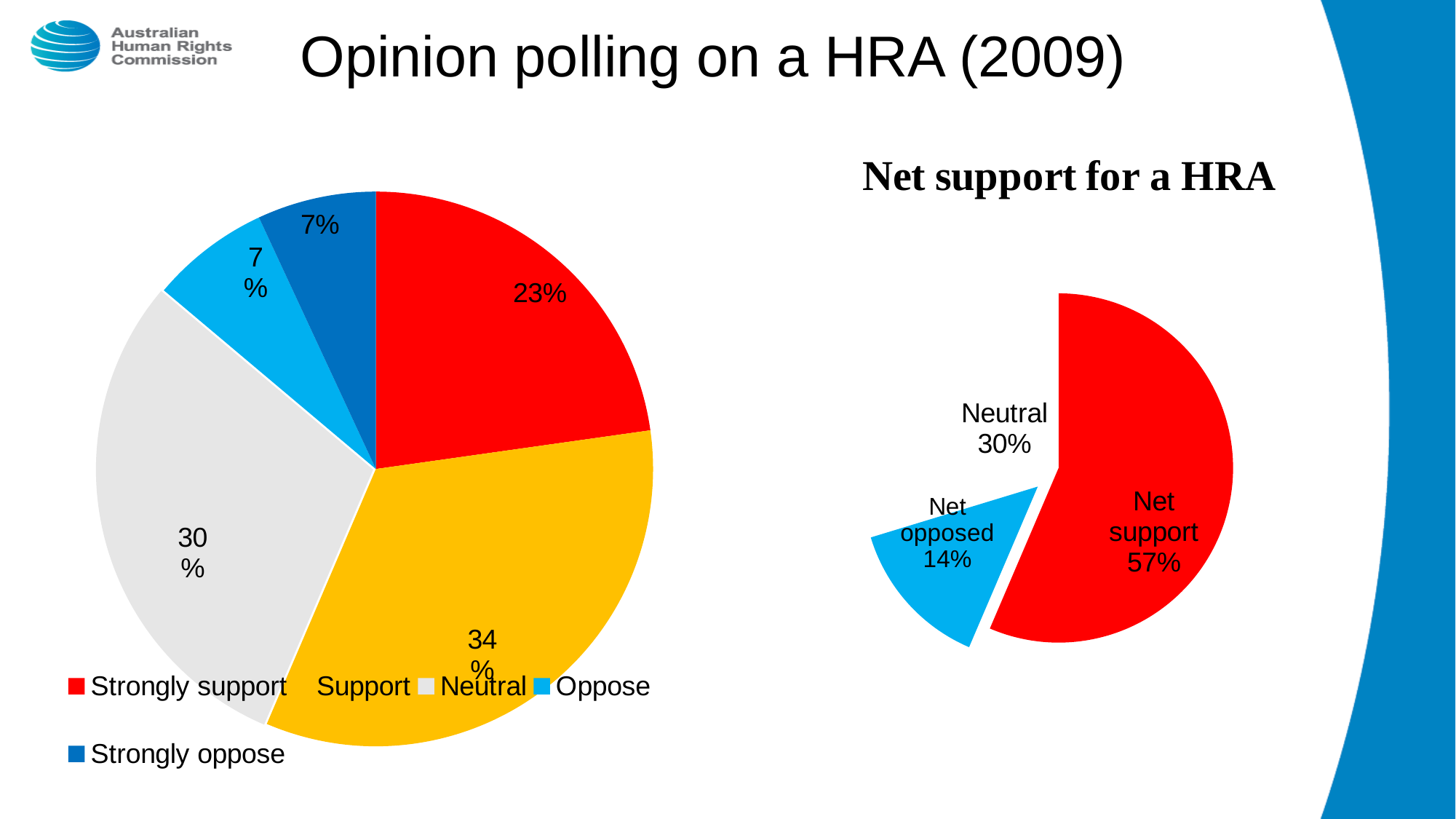
In the left pie chart, what is the difference between the Support and Strongly support percentages? 11% In the left pie chart, which is larger, Neutral or Strongly support? Neutral In the left pie chart, which category has the largest slice? Support How many categories does the legend of the left pie chart list? 5 In the left pie chart, what colour is the Neutral slice? Light grey In the left pie chart, what percentage is shown for Neutral? 30% In the 'Net support for a HRA' chart, what percentage is shown for Net opposed? 14% In the left pie chart, what percentage is shown for Support? 34% In the 'Net support for a HRA' chart, what is the difference between Net support and Net opposed? 43% What type of chart is the 'Net support for a HRA' chart? Pie chart In the left pie chart, what percentage is shown for Strongly support? 23% In the 'Net support for a HRA' chart, which category has the smallest slice? Net opposed